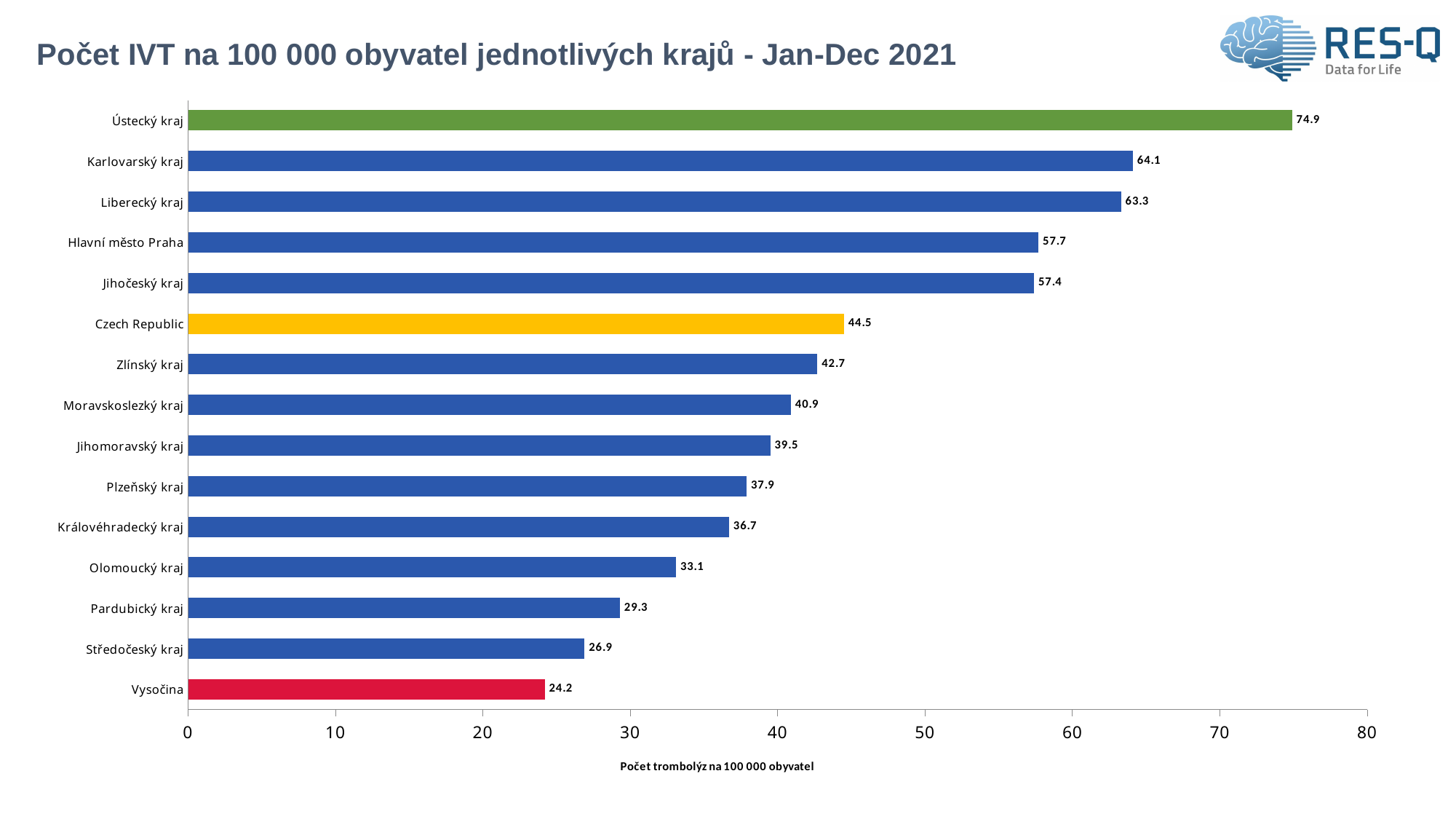
Which category has the lowest value? Vysočina What kind of chart is shown on the slide? bar chart Which category has the highest value? Ústecký kraj What is the value for Olomoucký kraj? 33.1 Is the value for Pardubický kraj greater or less than 30? less How many categories are shown in the chart? 15 Which has a larger value, Hlavní město Praha or Zlínský kraj? Hlavní město Praha What is the value for Czech Republic? 44.5 What is the title of the chart? Počet IVT na 100 000 obyvatel jednotlivých krajů - Jan-Dec 2021 What is the value for Ústecký kraj? 74.9 What is the difference between the values for Ústecký kraj and Vysočina? 50.7 What is the difference between the values for Karlovarský kraj and Liberecký kraj? 0.8